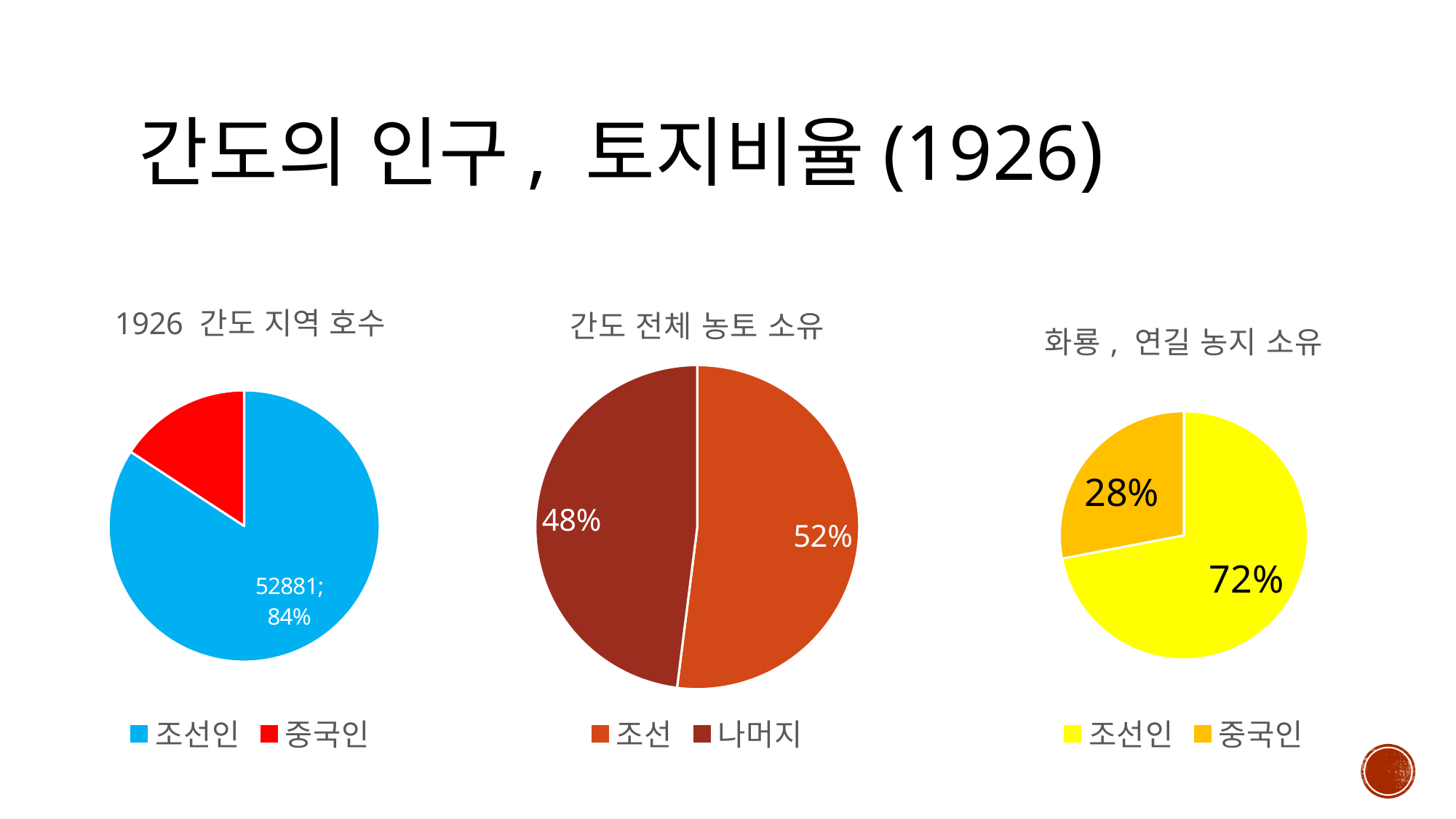
In the chart titled '화룡, 연길 농지 소유', what share is shown for 조선인? 72% In the chart titled '간도 전체 농토 소유', what share is shown for 조선? 52% In the chart titled '화룡, 연길 농지 소유', what share is shown for 중국인? 28% In the chart titled '화룡, 연길 농지 소유', which category has the smallest slice? 중국인 What kind of chart is the chart titled '간도 전체 농토 소유'? pie chart In the chart titled '화룡, 연길 농지 소유', what is the difference between the 조선인 share and the 중국인 share? 44% In the chart titled '간도 전체 농토 소유', what is the difference between the 조선 share and the 나머지 share? 4% In the chart titled '1926 간도 지역 호수', what value is shown for 조선인? 52881 In the chart titled '1926 간도 지역 호수', which category has the largest slice? 조선인 How many categories does the legend of the chart titled '1926 간도 지역 호수' list? 2